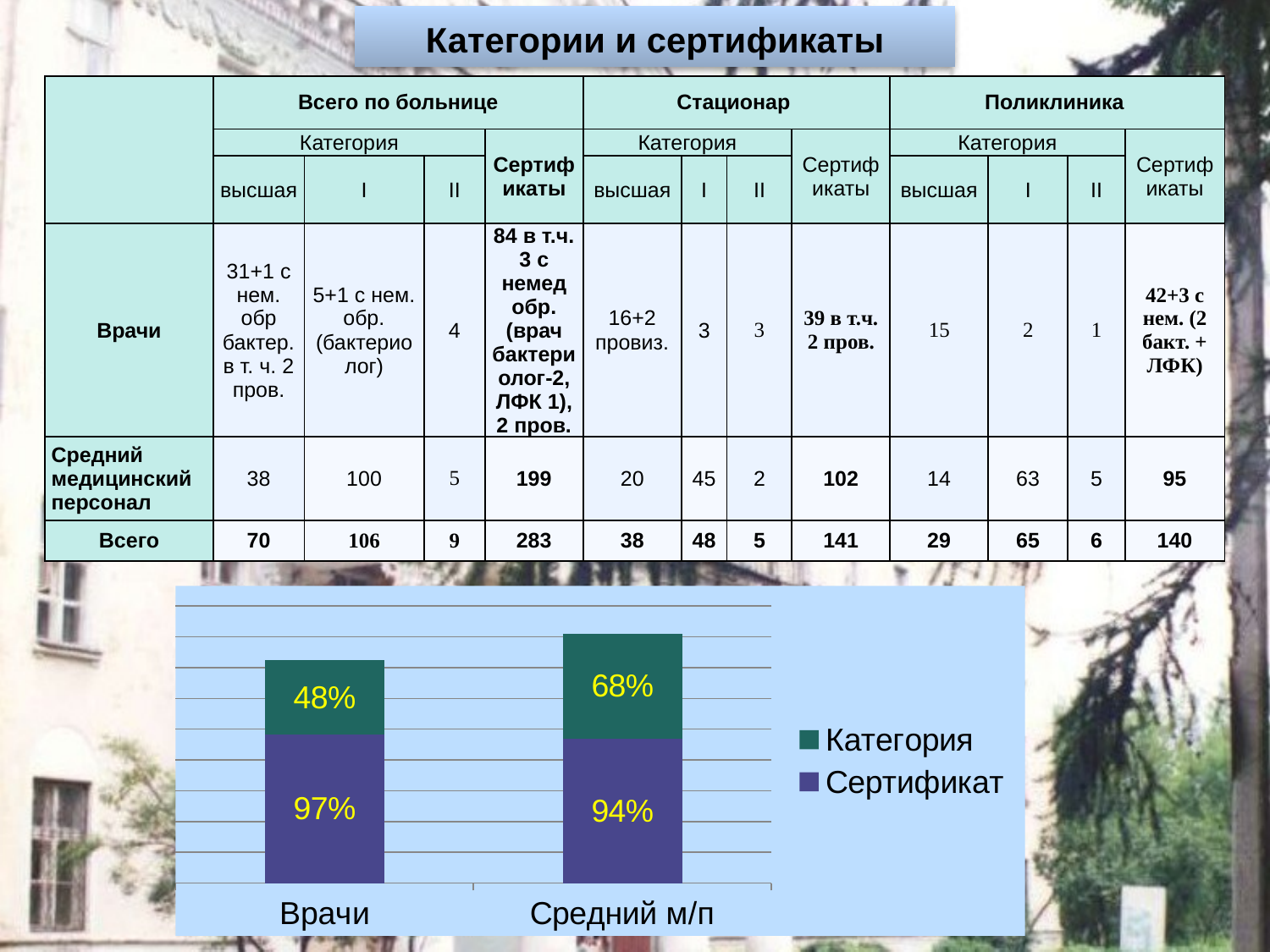
In the bar chart, what is the value of Категория for Врачи? 48% In the bar chart, is the Сертификат value for Врачи larger or smaller than the Сертификат value for Средний м/п? larger What kind of chart is shown at the bottom of the slide? Stacked bar chart In the bar chart, which category has the higher Категория value? Средний м/п How many series does the legend of the bar chart list? 2 In the bar chart, which category has the lower Сертификат value? Средний м/п In the bar chart, what is the value of Категория for Средний м/п? 68% In the bar chart, what is the value of Сертификат for Врачи? 97% In the bar chart, what is the difference between the Сертификат values for Врачи and Средний м/п? 3% In the bar chart, what is the value of Сертификат for Средний м/п? 94% How many categories are shown on the x axis of the bar chart? 2 In the bar chart, what is the difference between the Категория values for Средний м/п and Врачи? 20%